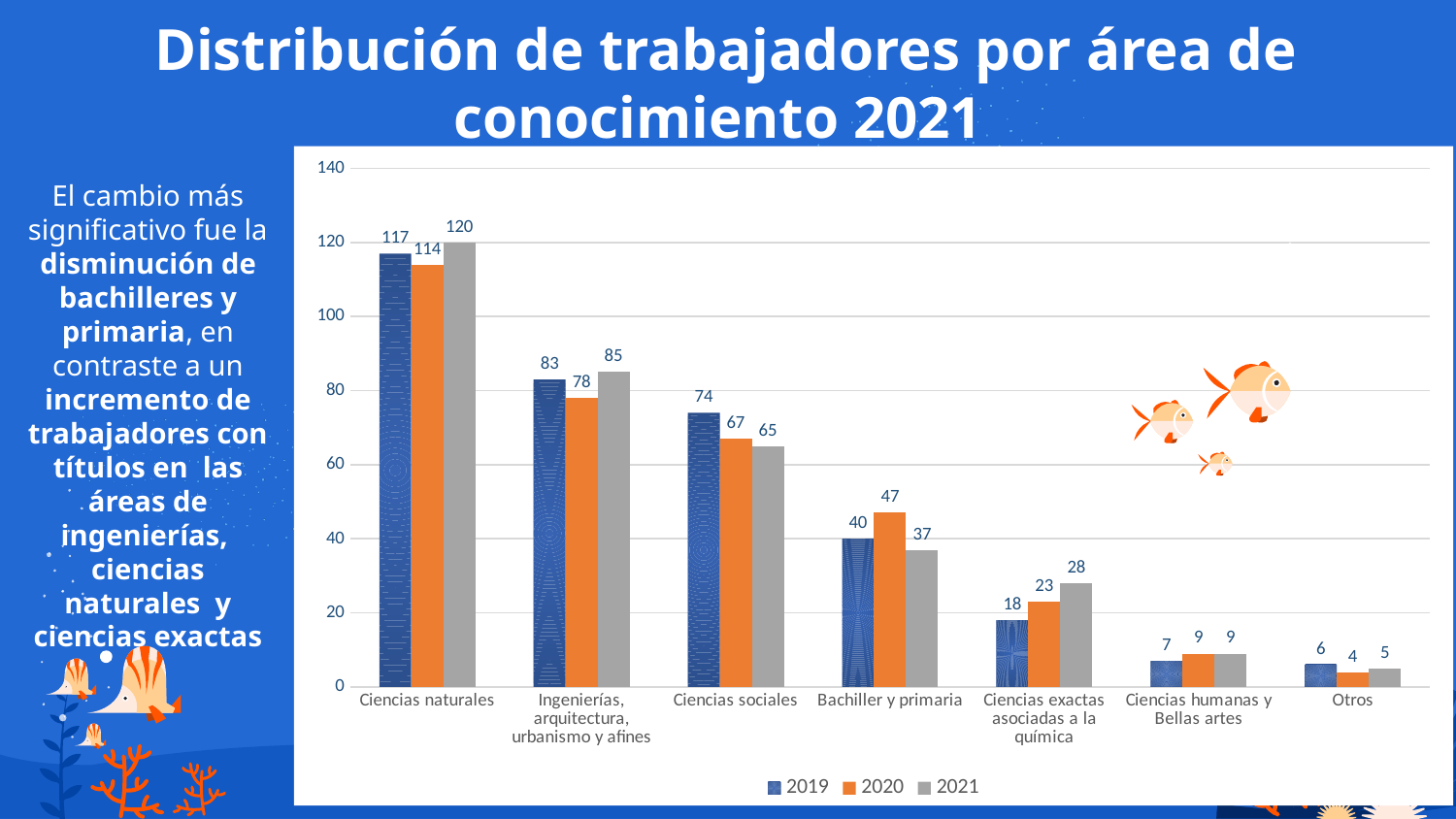
What is the difference between the 2021 and 2019 values for Ingenierías, arquitectura, urbanismo y afines? 2 How many series does the legend list? 3 What is the title of the chart? Distribución de trabajadores por área de conocimiento 2021 Which is larger for Ciencias sociales: the 2019 value or the 2021 value? 2019 What is the value for Ciencias exactas asociadas a la química in 2019? 18 What is the value for Ciencias naturales in 2021? 120 Do the 2021 values rise or fall from Ciencias naturales to Otros along the x axis? Fall Which category has the lowest value in the 2020 series? Otros Which category has the highest value in the 2019 series? Ciencias naturales How many categories are shown on the x axis? 7 What is the value for Bachiller y primaria in 2020? 47 What kind of chart is shown on the slide? Bar chart